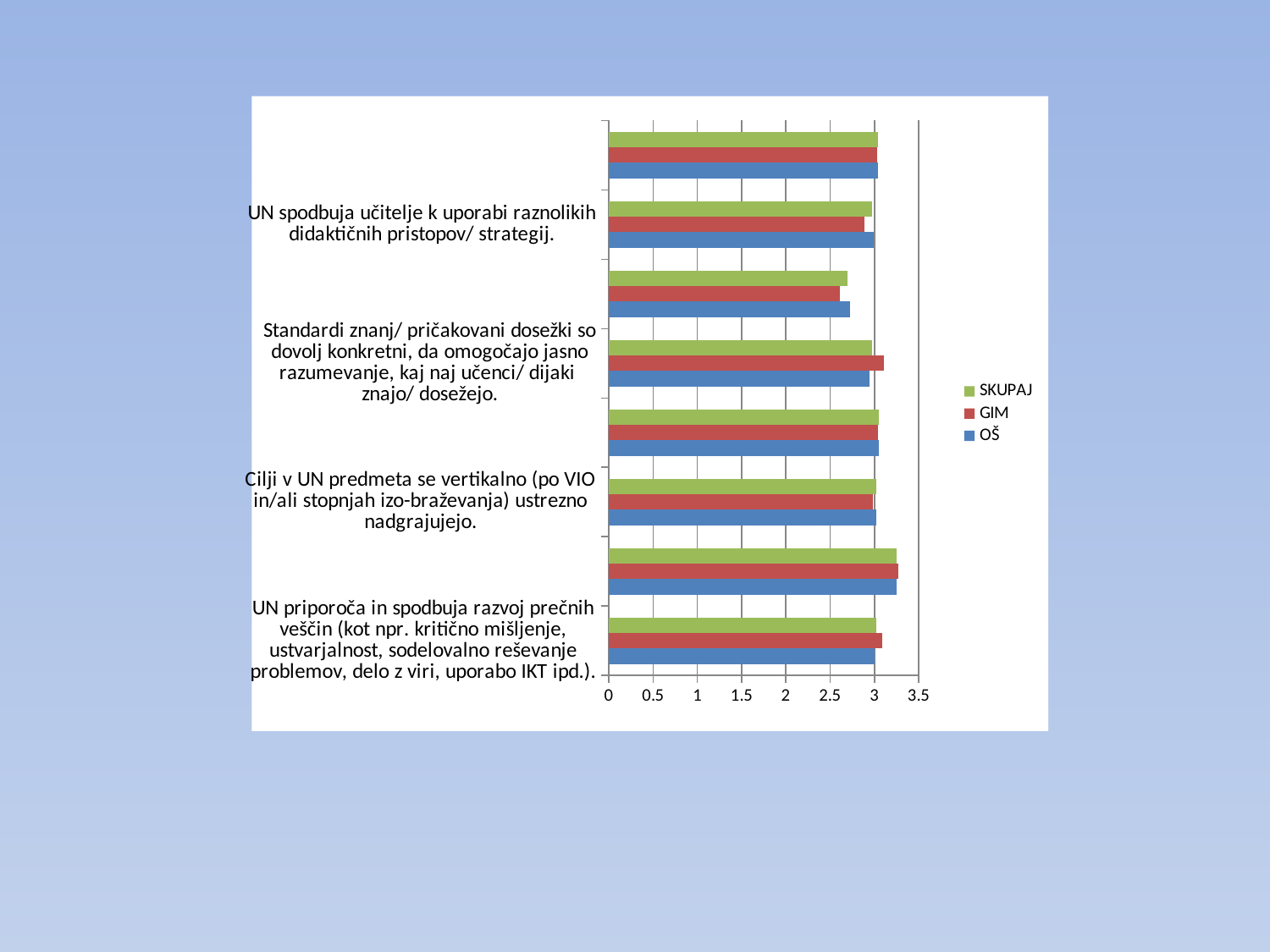
What kind of chart is shown on the slide? bar chart Is the SKUPAJ value for 'Cilji v UN predmeta se vertikalno (po VIO in/ali stopnjah izo-braževanja) ustrezno nadgrajujejo.' greater or less than 2.5? greater What is the highest value shown on the horizontal axis? 3.5 What colour are the bars for the OŠ series? blue How many groups of bars are plotted in the chart? 8 How many series does the legend list? 3 Is the OŠ value for 'Standardi znanj/ pričakovani dosežki so dovolj konkretni, da omogočajo jasno razumevanje, kaj naj učenci/ dijaki znajo/ dosežejo.' greater or less than 2? greater Is the OŠ value for 'UN spodbuja učitelje k uporabi raznolikih didaktičnih pristopov/ strategij.' greater or less than 2? greater Which series are listed in the legend? SKUPAJ, GIM, OŠ